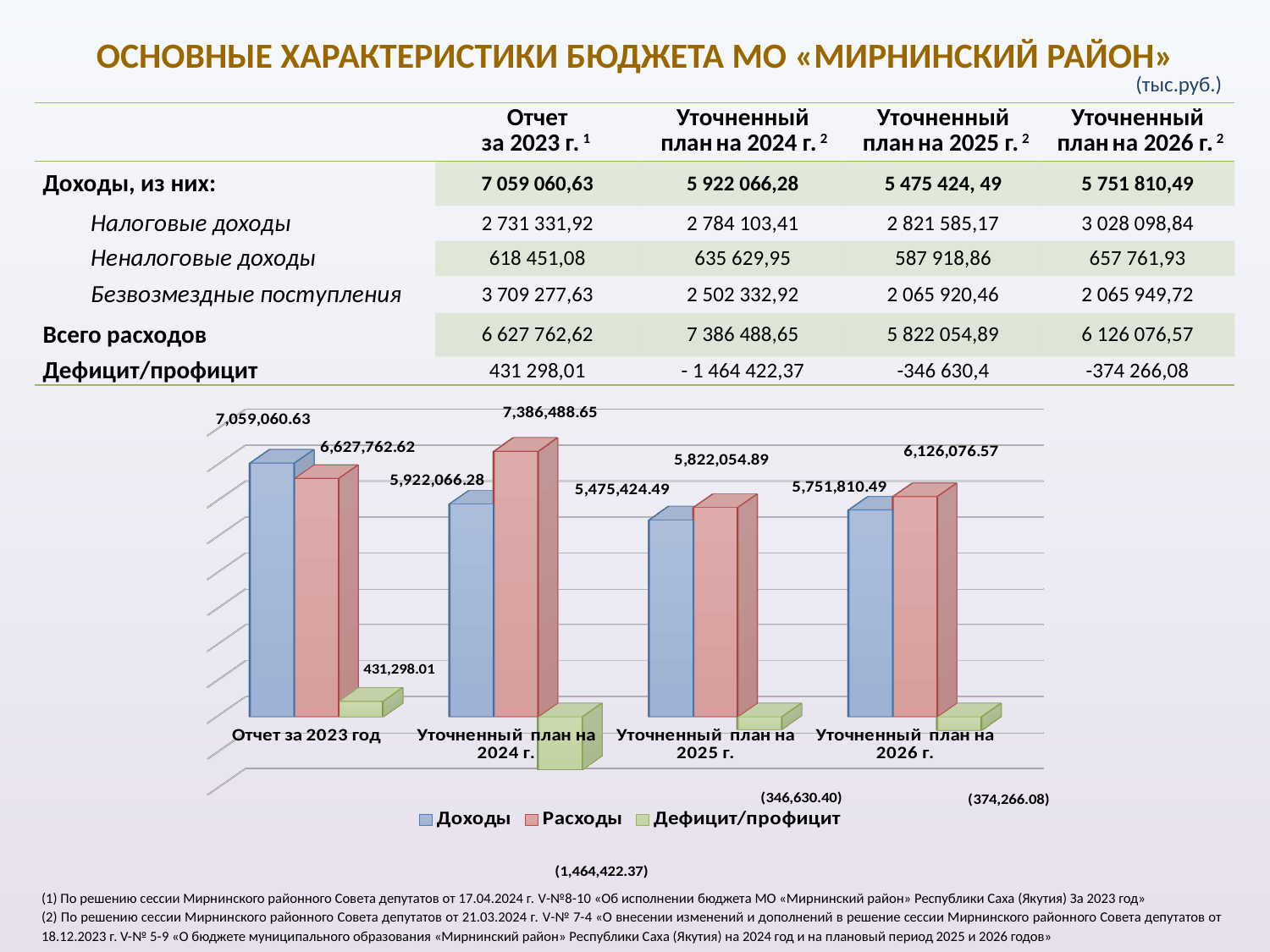
How many series does the chart legend list? 3 What kind of chart is shown on the slide? bar chart What is the value of Доходы for Уточненный план на 2026 г. in the chart? 5,751,810.49 What is the difference between Расходы and Доходы for Уточненный план на 2026 г. in the chart? 374,266.08 In the chart, which is larger for Уточненный план на 2024 г.: Доходы or Расходы? Расходы What is the value of Расходы for Уточненный план на 2024 г. in the chart? 7,386,488.65 Which category has the lowest Расходы value in the chart? Уточненный план на 2025 г. Which category has the highest Доходы value in the chart? Отчет за 2023 год How many categories are shown on the x axis of the chart? 4 What is the value of Доходы for Отчет за 2023 год in the chart? 7,059,060.63 Which series in the chart legend is shown in green? Дефицит/профицит What is the value of Дефицит/профицит for Уточненный план на 2025 г. in the chart? (346,630.40)